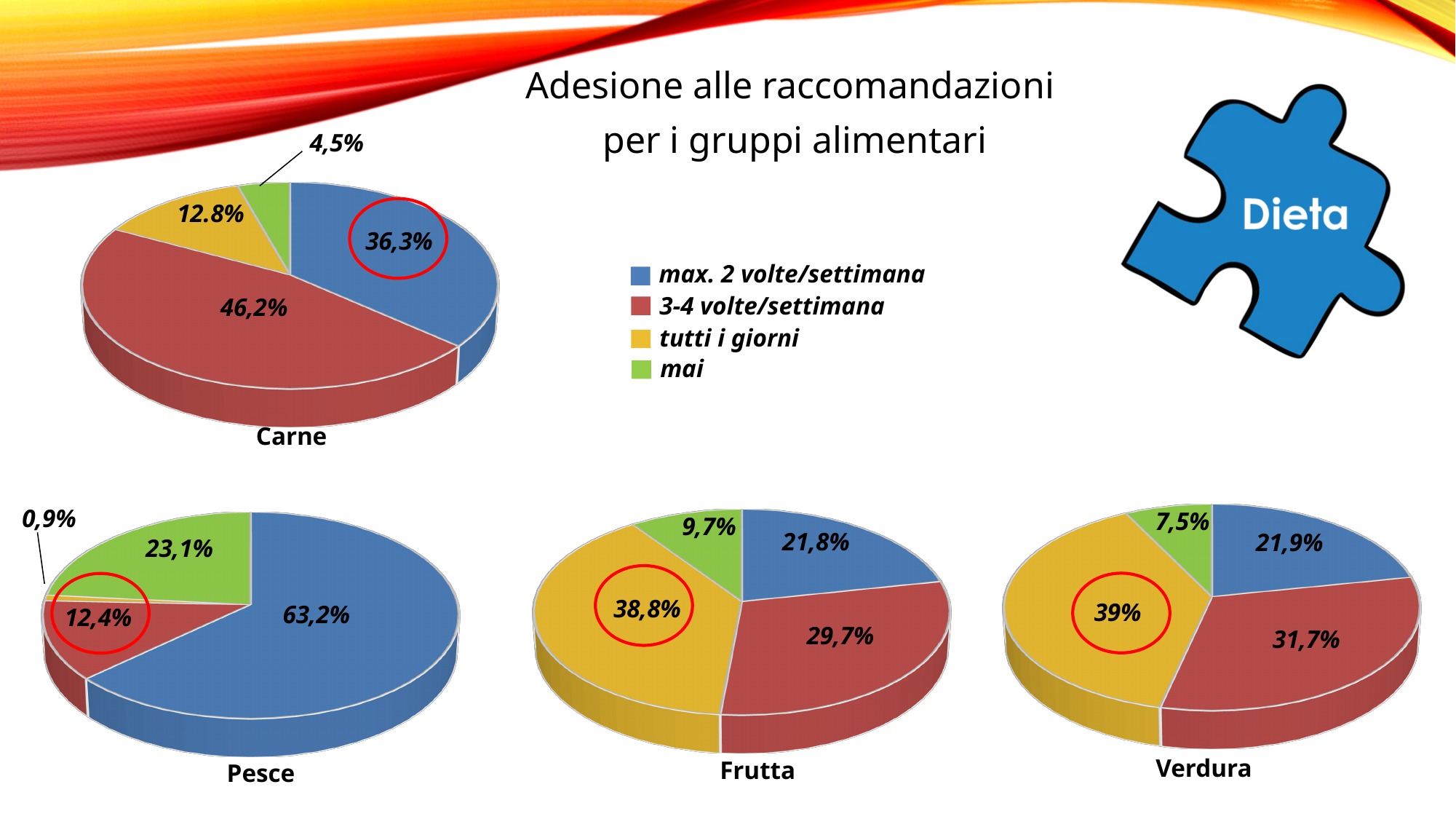
How many pie charts are shown on the slide? 4 In the Verdura pie chart, what is the value for '3-4 volte/settimana'? 31,7% In the Frutta pie chart, which category has the largest slice? tutti i giorni In the Verdura pie chart, what is the difference between 'tutti i giorni' and 'mai'? 31,5% In the Pesce pie chart, what is the value for 'max. 2 volte/settimana'? 63,2% In the Carne pie chart, what is the value for '3-4 volte/settimana'? 46,2% In the Carne pie chart, which is larger: 'max. 2 volte/settimana' or '3-4 volte/settimana'? 3-4 volte/settimana In the Frutta pie chart, what is the value for 'mai'? 9,7% How many categories does the legend list? 4 What type of chart is used for Pesce? Pie chart In the Carne pie chart, what is the value for 'mai'? 4,5% In the Pesce pie chart, which category has the smallest slice? tutti i giorni